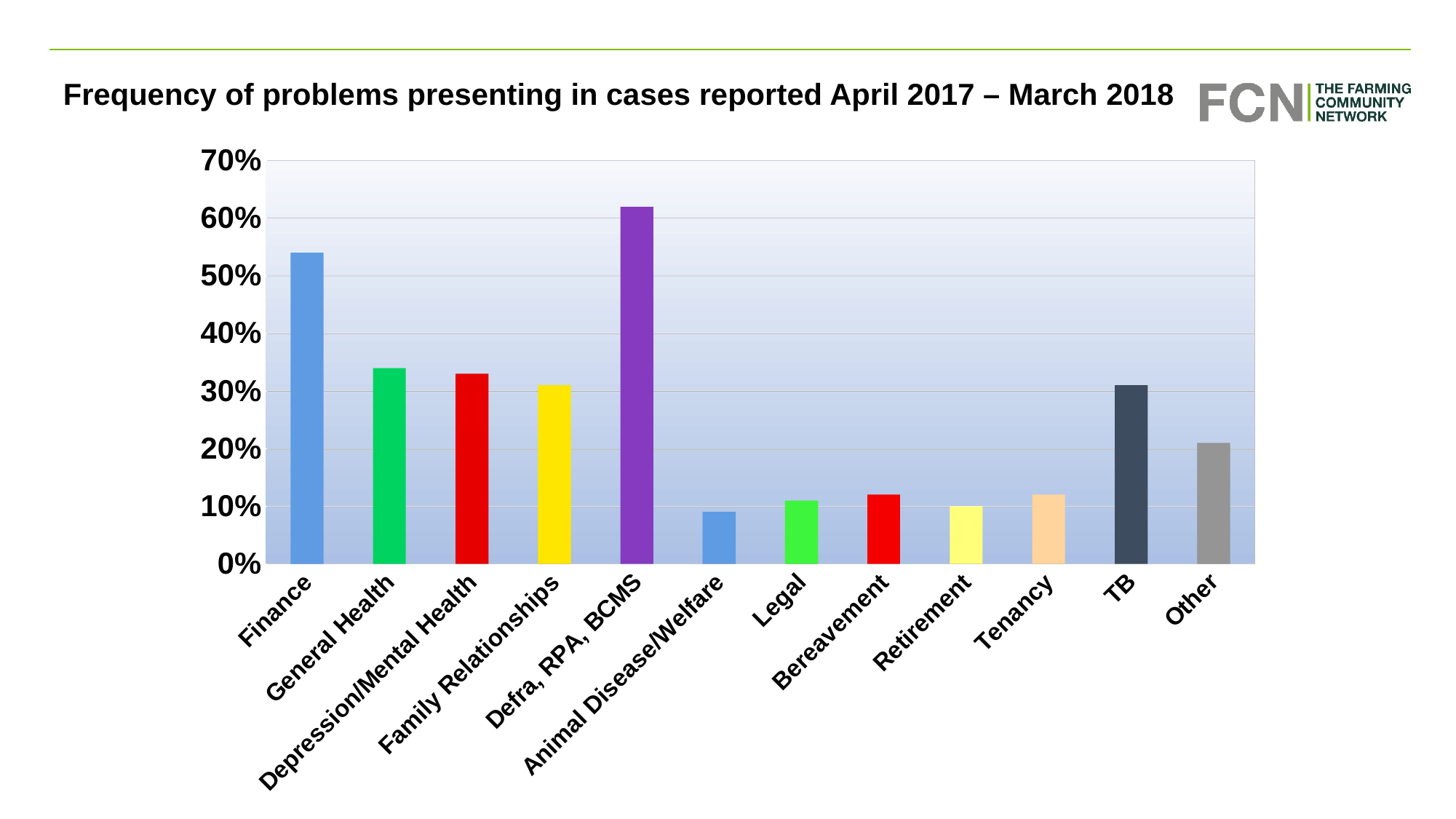
Is the value for General Health greater or less than 30%? greater What is the title of the chart? Frequency of problems presenting in cases reported April 2017 – March 2018 How many problem categories are shown on the x axis? 12 Which is larger, the value for Finance or the value for General Health? Finance Which problem category has the highest frequency? Defra, RPA, BCMS Is the value for Defra, RPA, BCMS greater or less than 60%? greater Is the value for Finance greater or less than 50%? greater Which is larger, the value for Other or the value for TB? TB What kind of chart is shown on the slide? bar chart